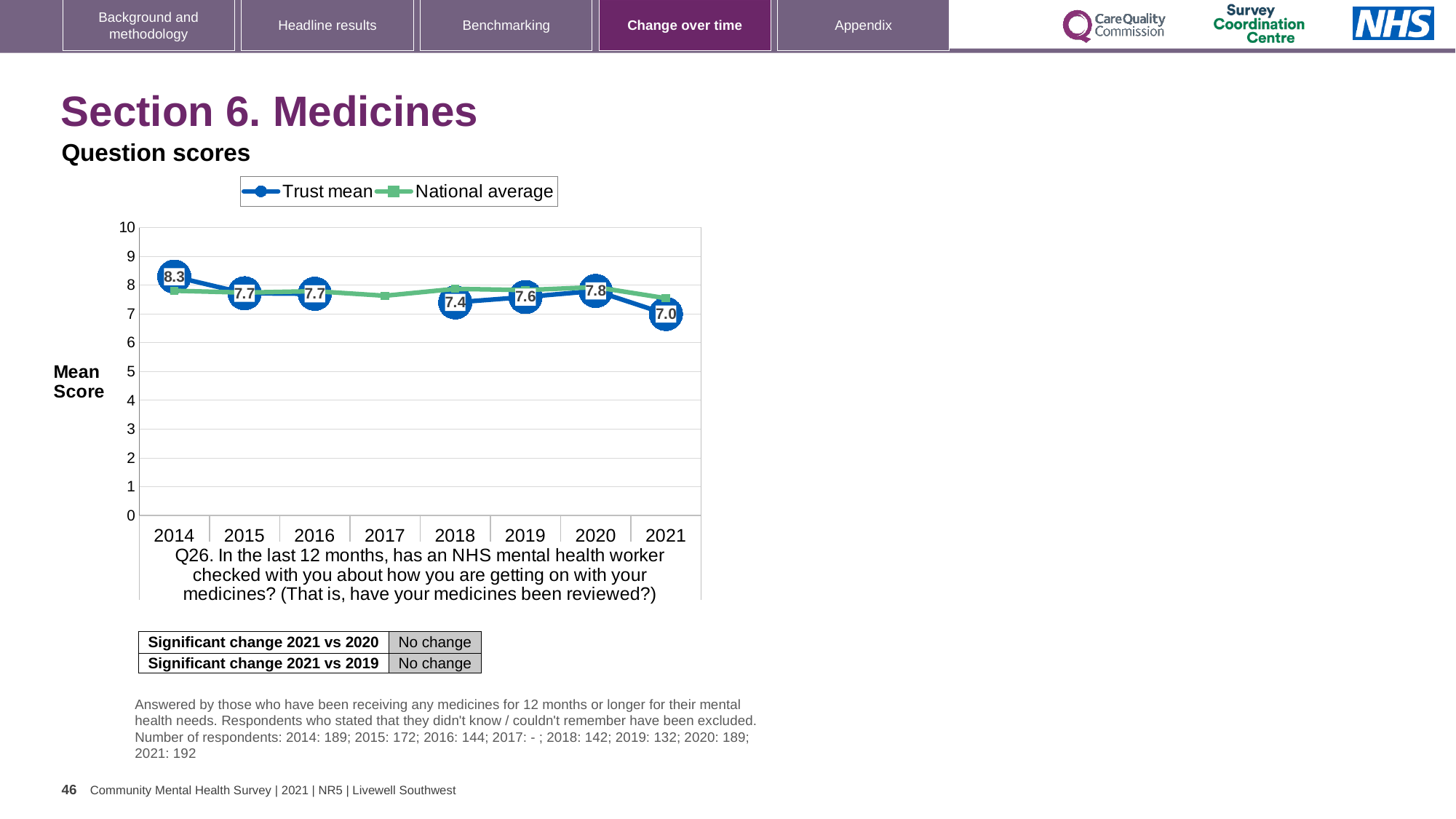
How many series does the chart legend list? 2 What is the Trust mean score for 2021? 7.0 Does the Trust mean score rise or fall from 2020 to 2021? Fall Is the National average value for 2017 greater or less than 5? greater What kind of chart is shown on the slide? Line chart In which year is the Trust mean score highest? 2014 Which year has the larger Trust mean score, 2019 or 2020? 2020 What is the Trust mean score for 2018? 7.4 How many years are shown on the x axis of the chart? 8 In which year is the Trust mean score lowest? 2021 What is the difference between the Trust mean score in 2014 and in 2021? 1.3 What is the Trust mean score for 2014? 8.3